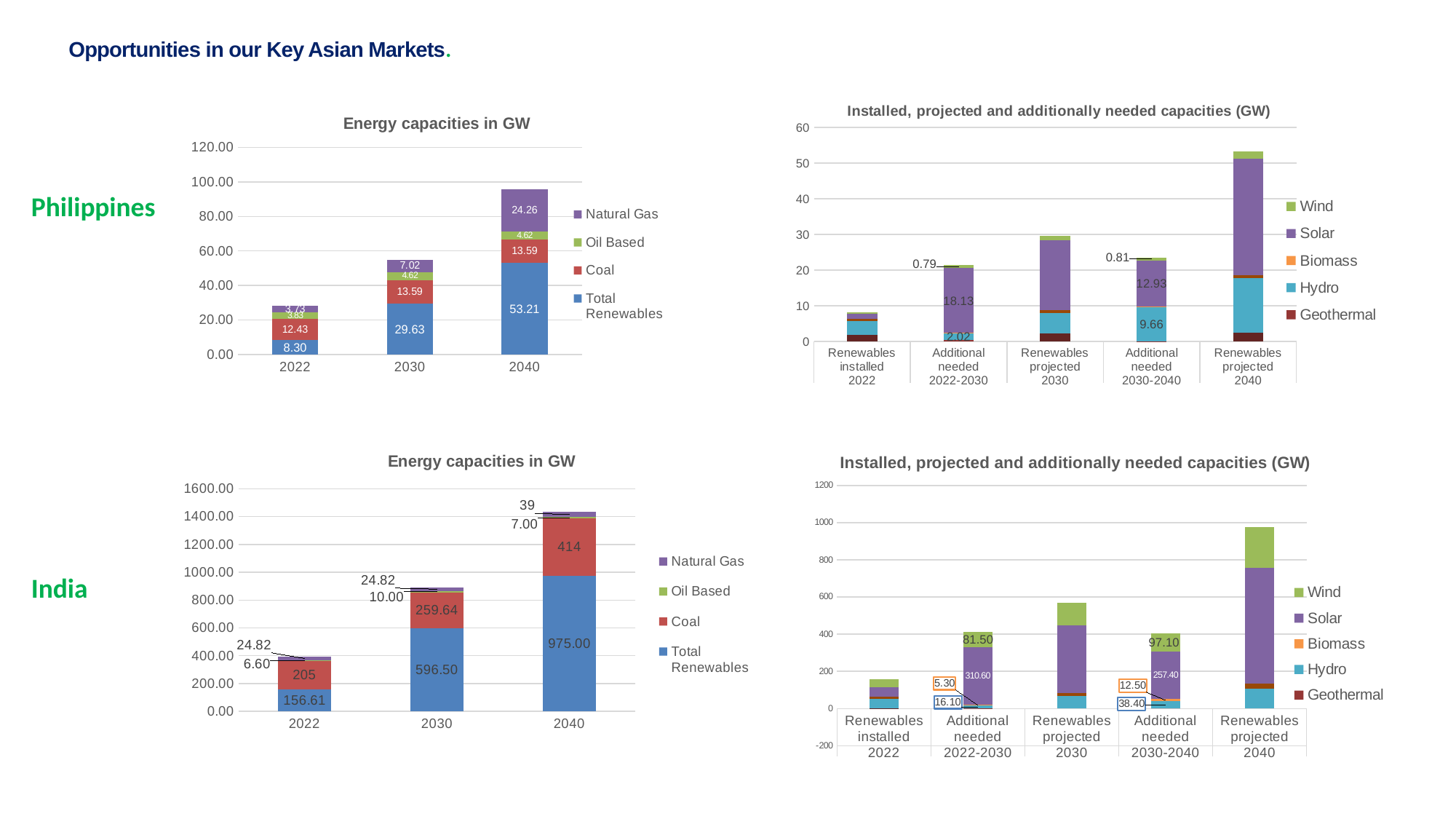
In the Philippines 'Energy capacities in GW' chart, what is the Coal value in 2022? 12.43 In the India 'Installed, projected and additionally needed capacities (GW)' chart, which is larger: Wind for 'Additional needed 2022-2030' or Wind for 'Additional needed 2030-2040'? Additional needed 2030-2040 In the India 'Energy capacities in GW' chart, what is the difference between Total Renewables in 2030 and 2022? 439.89 In the Philippines 'Installed, projected and additionally needed capacities (GW)' chart, is the total for 'Renewables projected 2040' greater or less than 50? greater In the Philippines 'Installed, projected and additionally needed capacities (GW)' chart, how many series does the legend list? 5 In the Philippines 'Installed, projected and additionally needed capacities (GW)' chart, what is the Solar value for 'Additional needed 2022-2030'? 18.13 In the India 'Energy capacities in GW' chart, does Total Renewables rise or fall from 2022 to 2040? rise In the Philippines 'Energy capacities in GW' chart, which year has the highest Total Renewables value? 2040 In the India 'Installed, projected and additionally needed capacities (GW)' chart, what is the Solar value for 'Additional needed 2030-2040'? 257.40 In the Philippines 'Energy capacities in GW' chart, what is the value for Total Renewables in 2040? 53.21 In the Philippines 'Energy capacities in GW' chart, how much larger is Natural Gas in 2040 than in 2030? 17.24 In the India 'Energy capacities in GW' chart, what is the Coal value in 2040? 414